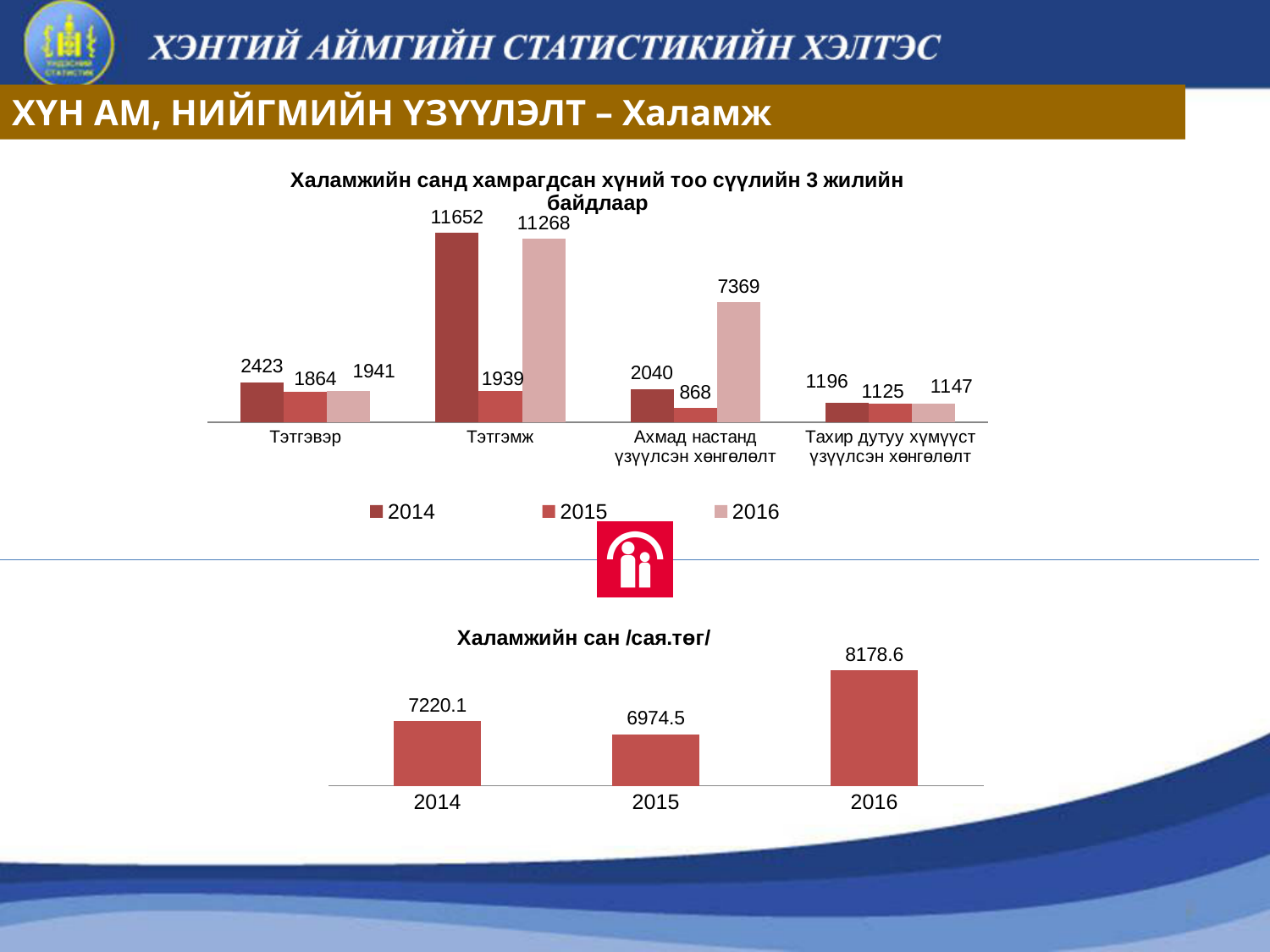
What kind of chart is the bottom chart (Халамжийн сан /сая.төг/)? Bar chart In the top chart (Халамжийн санд хамрагдсан хүний тоо), what is the difference between the 2014 and 2016 values for Тэтгэмж? 384 In the bottom chart (Халамжийн сан /сая.төг/), which year has the lowest value? 2015 In the top chart (Халамжийн санд хамрагдсан хүний тоо), how many series does the legend list? 3 In the bottom chart (Халамжийн сан /сая.төг/), what is the value for 2016? 8178.6 In the top chart (Халамжийн санд хамрагдсан хүний тоо), what is the value for Тэтгэвэр in 2015? 1864 In the top chart (Халамжийн санд хамрагдсан хүний тоо), what is the value for Тэтгэмж in 2014? 11652 In the bottom chart (Халамжийн сан /сая.төг/), what is the difference between the 2016 and 2014 values? 958.5 In the top chart (Халамжийн санд хамрагдсан хүний тоо), what is the value for Ахмад настанд үзүүлсэн хөнгөлөлт in 2016? 7369 In the top chart (Халамжийн санд хамрагдсан хүний тоо), which category has the lowest value for 2015? Ахмад настанд үзүүлсэн хөнгөлөлт In the top chart (Халамжийн санд хамрагдсан хүний тоо), which is larger for Тахир дутуу хүмүүст үзүүлсэн хөнгөлөлт: the 2014 value or the 2015 value? 2014 In the top chart (Халамжийн санд хамрагдсан хүний тоо), how many categories are shown on the x axis? 4